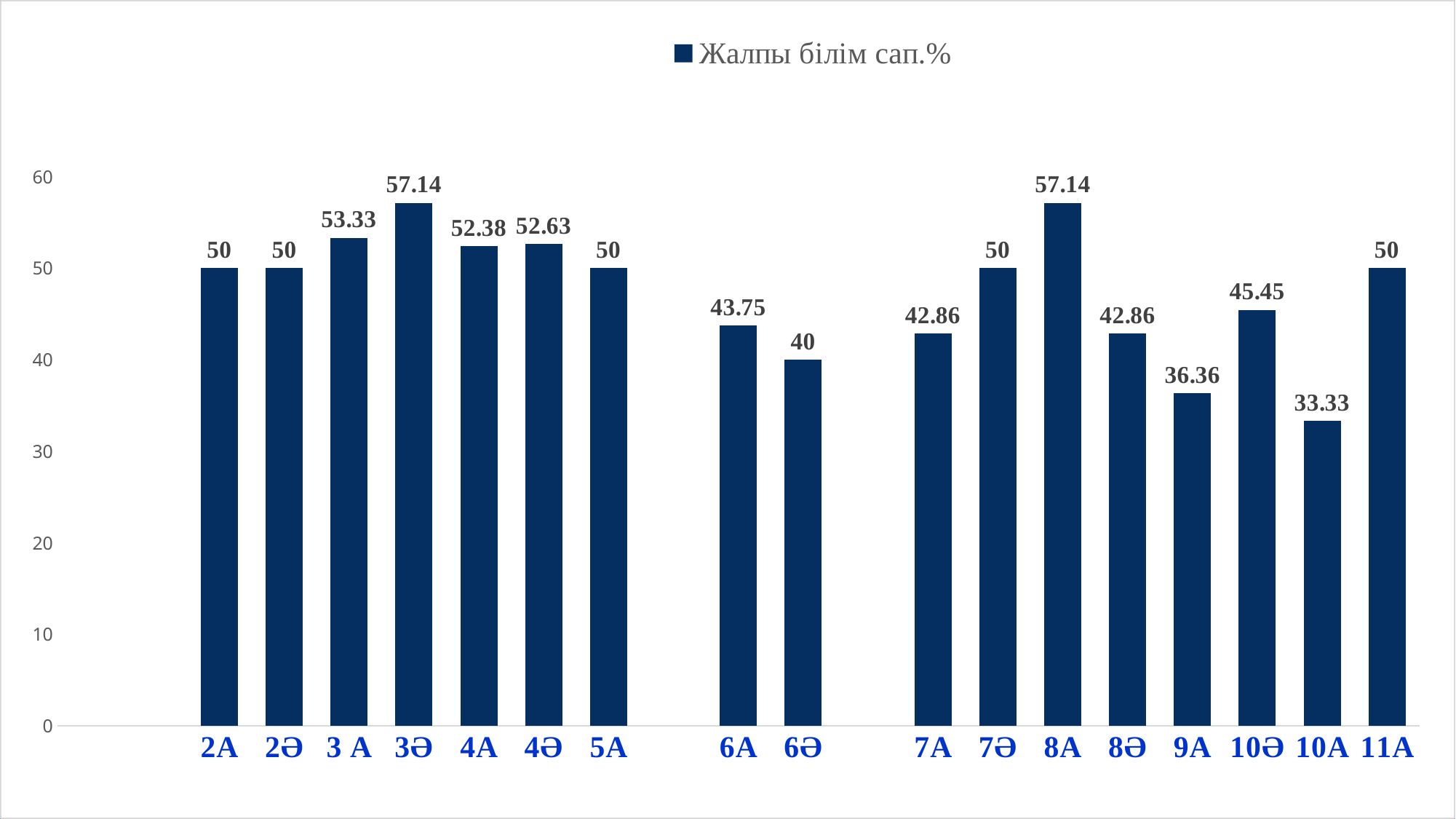
How many categories are shown on the x axis? 17 What is the value for 10Ә? 45.45 What is the value for 6Ә? 40 What is the difference between the values for 8А and 8Ә? 14.28 Which is larger, the value for 4Ә or the value for 4А? 4Ә What is the value for 3Ә? 57.14 Is the value for 6А greater or less than 40? greater What is the highest value shown on the chart? 57.14 What is the value for 9А? 36.36 How many series does the legend list? 1 Which category has the lowest value? 10А What kind of chart is this? bar chart